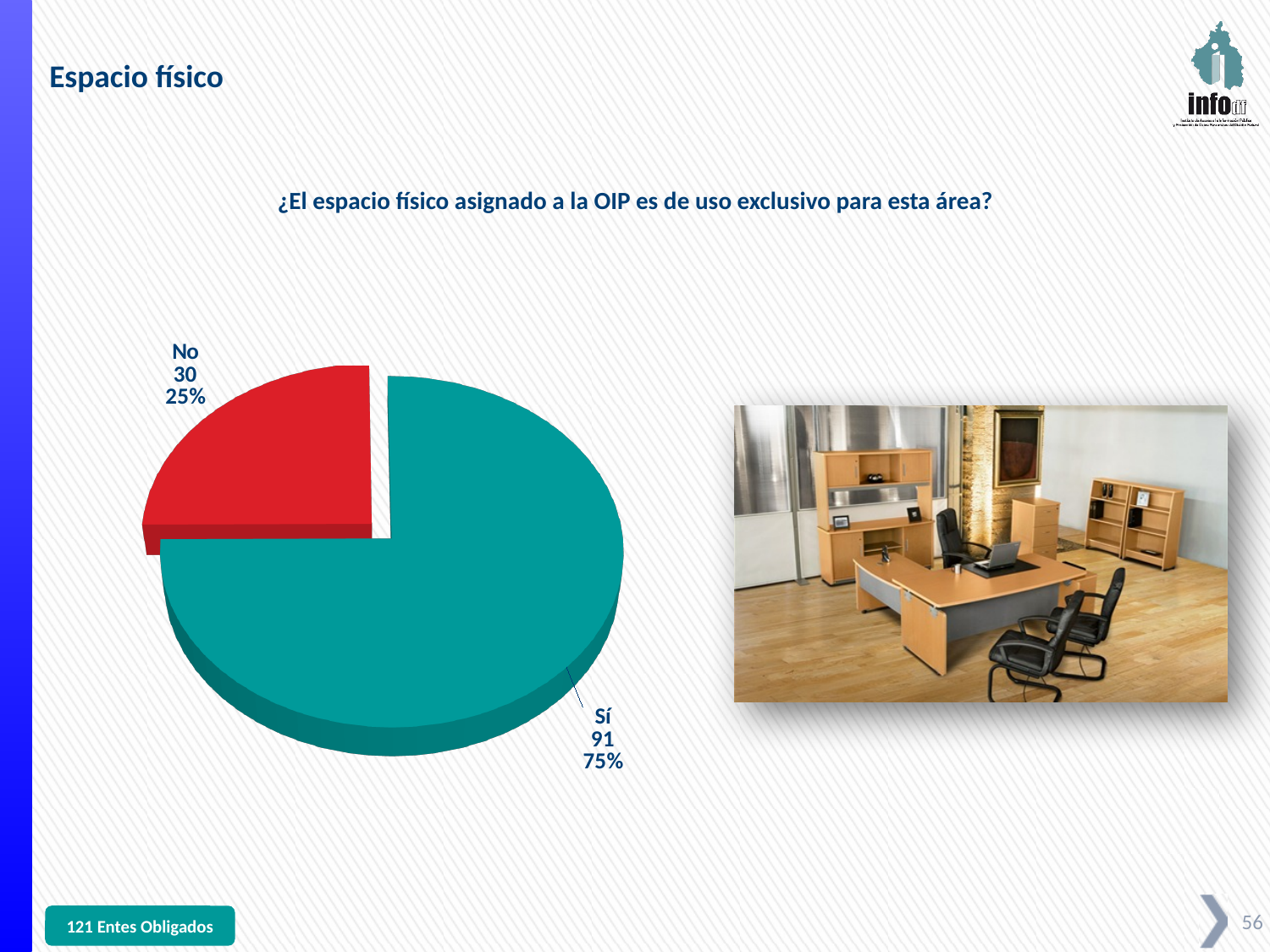
What percentage share does the "Sí" slice represent? 75% What colour is the "No" slice? red Which slice is the largest? Sí What kind of chart is shown on the slide? pie chart What is the total of the two slice counts? 121 Which is larger, the count for "Sí" or the count for "No"? Sí How many slices does the pie chart have? 2 What is the difference between the counts for "Sí" and "No"? 61 What percentage share does the "No" slice represent? 25% What is the count for the "Sí" slice? 91 What is the count for the "No" slice? 30 Which slice is the smallest? No